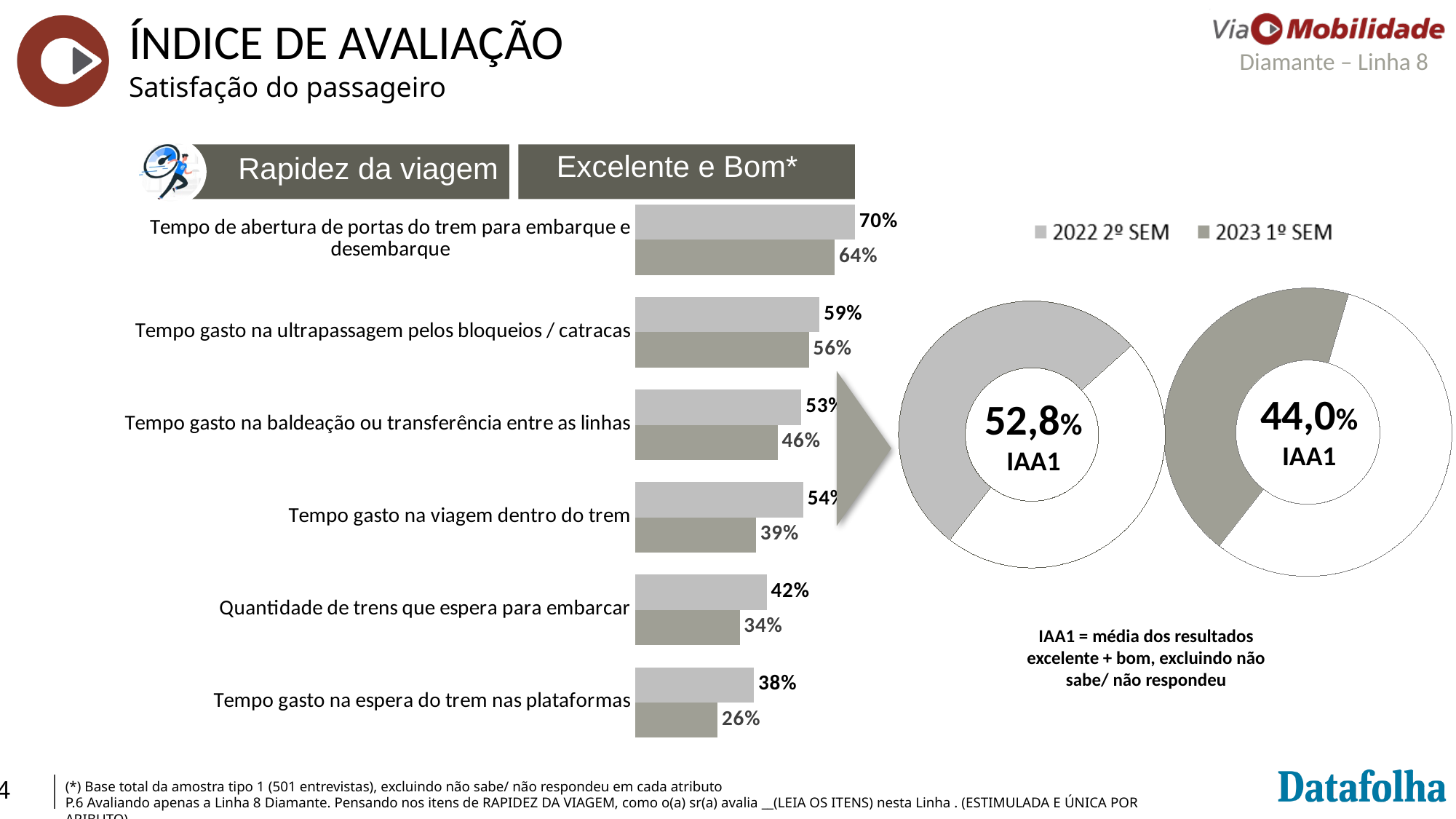
What kind of chart is used to show the "Excelente e Bom*" results by category? Bar chart In the bar chart, what is the 2023 1º SEM value for "Tempo gasto na espera do trem nas plataformas"? 26% What is the difference between the IAA1 values shown in the two donut charts (52,8% and 44,0%)? 8,8% In the bar chart, what is the 2023 1º SEM value for "Tempo de abertura de portas do trem para embarque e desembarque"? 64% In the bar chart, which category has the highest 2022 2º SEM value? Tempo de abertura de portas do trem para embarque e desembarque How many series does the legend list? 2 How many categories are shown in the bar chart? 6 In the bar chart, which is larger for "Quantidade de trens que espera para embarcar": the 2022 2º SEM value or the 2023 1º SEM value? 2022 2º SEM In the donut chart on the right (2023 1º SEM), what is the IAA1 value? 44,0% In the bar chart, which category has the lowest 2023 1º SEM value? Tempo gasto na espera do trem nas plataformas In the bar chart, what is the 2022 2º SEM value for "Tempo gasto na viagem dentro do trem"? 54% In the bar chart, what is the difference between the 2022 2º SEM and 2023 1º SEM values for "Tempo gasto na viagem dentro do trem"? 15%